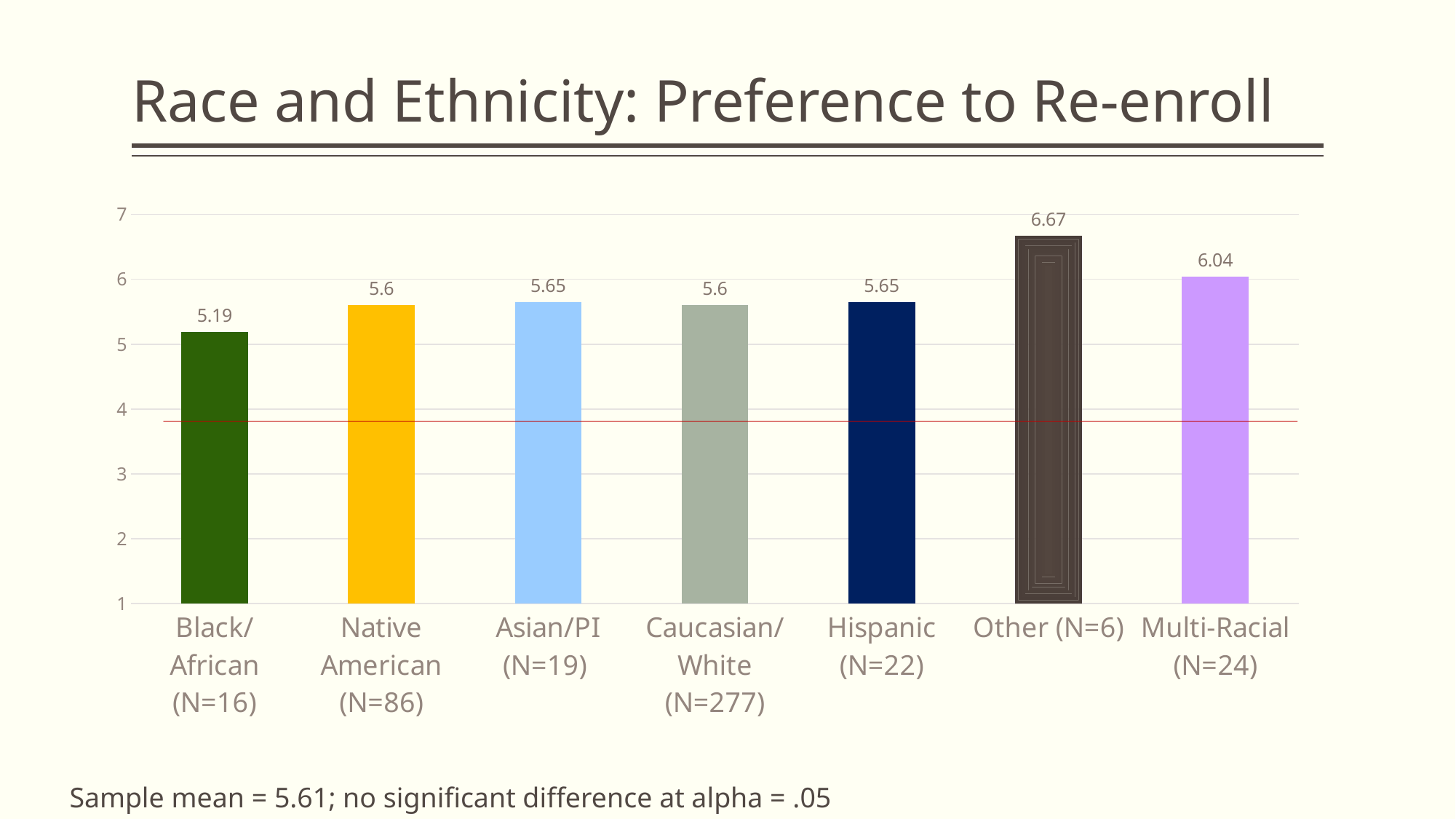
What kind of chart is shown on the slide? Bar chart What is the difference between the values for Multi-Racial (N=24) and Hispanic (N=22)? 0.39 Which category has the lowest value? Black/African (N=16) How many categories are shown on the x axis? 7 What is the value for Multi-Racial (N=24)? 6.04 Which category has the highest value? Other (N=6) What is the value for Other (N=6)? 6.67 Which is larger, the value for Multi-Racial (N=24) or the value for Native American (N=86)? Multi-Racial (N=24) What is the value for Caucasian/White (N=277)? 5.6 What is the title of the slide? Race and Ethnicity: Preference to Re-enroll What is the value for Black/African (N=16)? 5.19 What is the difference between the values for Other (N=6) and Black/African (N=16)? 1.48